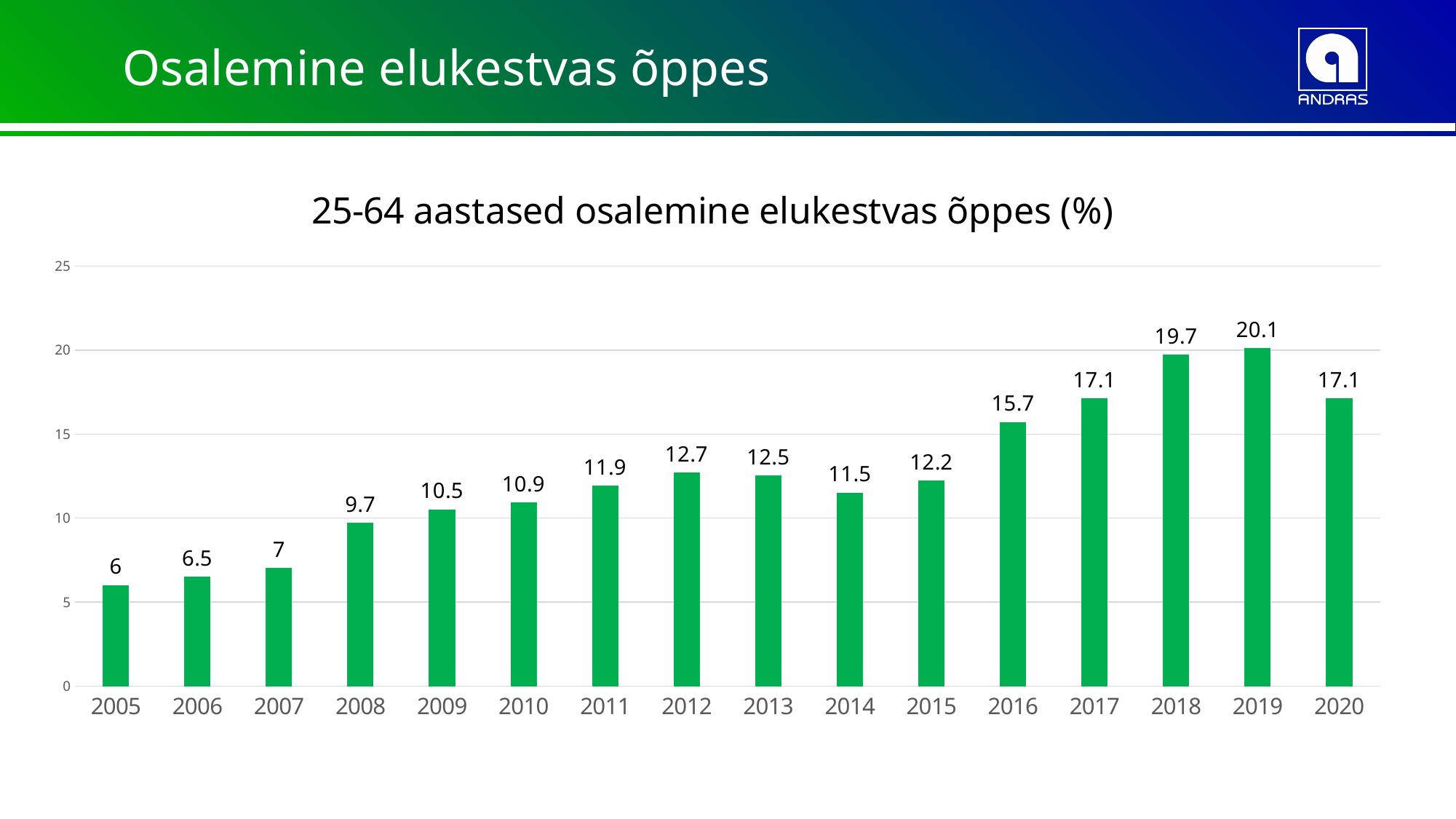
What kind of chart is shown on the slide? bar chart How many years are shown on the x axis? 16 What is the value for 2019? 20.1 Which is larger, the value for 2012 or the value for 2013? 2012 Which year has the highest value? 2019 What is the value for 2005? 6 Which year has the lowest value? 2005 What is the title of the chart? 25-64 aastased osalemine elukestvas õppes (%) What is the difference between the values for 2019 and 2020? 3 Is the value for 2018 greater or less than 15? greater What is the difference between the values for 2016 and 2015? 3.5 What is the value for 2014? 11.5